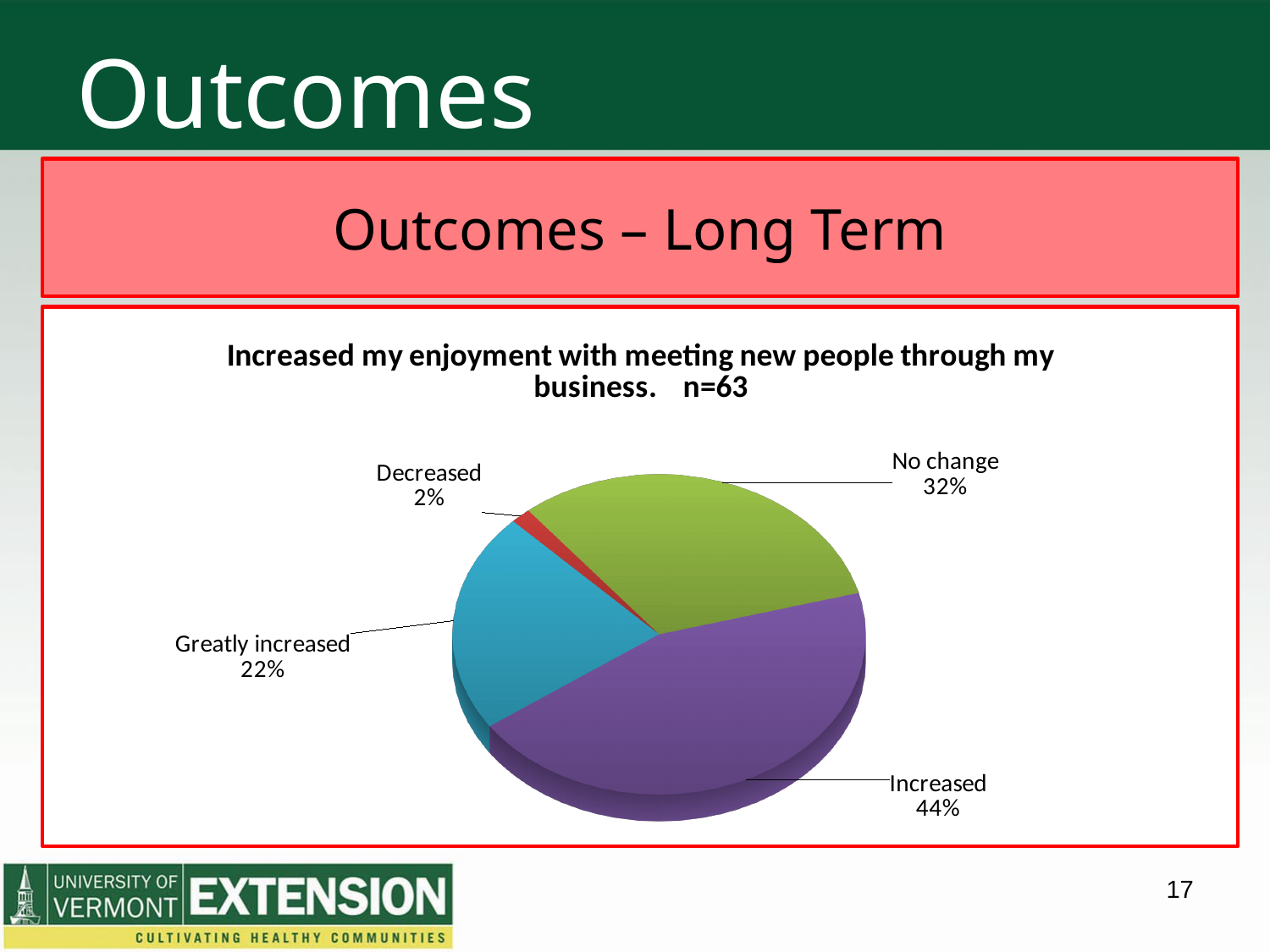
What percentage of respondents reported 'No change'? 32% What is the difference in percentage points between 'Increased' and 'No change'? 12 What is the sample size (n) stated in the chart title? 63 Which is larger: the share for 'Greatly increased' or the share for 'No change'? No change What percentage of respondents reported 'Increased'? 44% What type of chart is shown on the slide? Pie chart What colour is the 'Increased' slice of the pie? Purple What percentage of respondents reported 'Greatly increased'? 22% Which response category has the largest share of the pie? Increased What percentage of respondents reported 'Decreased'? 2% Which response category has the smallest share of the pie? Decreased How many response categories are shown in the pie chart? 4